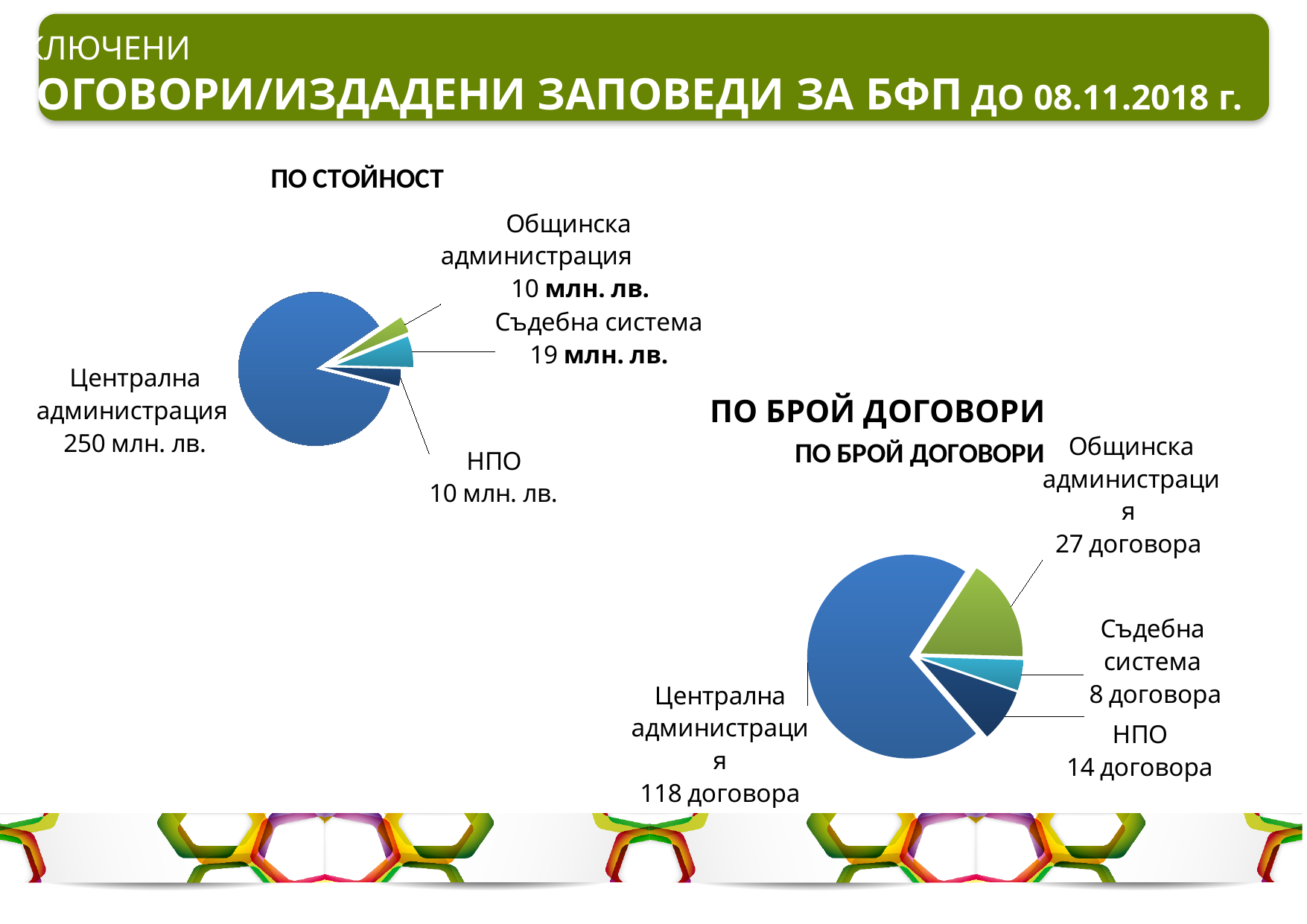
In the "ПО БРОЙ ДОГОВОРИ" chart, which category has the fewest contracts? Съдебна система In the "ПО БРОЙ ДОГОВОРИ" chart, which has more contracts, Общинска администрация or НПО? Общинска администрация In the "ПО СТОЙНОСТ" chart, what is the difference between Съдебна система and НПО? 9 млн. лв. In the "ПО БРОЙ ДОГОВОРИ" chart, how many contracts does НПО have? 14 договора What kind of chart is the "ПО СТОЙНОСТ" chart? Pie chart In the "ПО СТОЙНОСТ" chart, what is the value for Централна администрация? 250 млн. лв. In the "ПО БРОЙ ДОГОВОРИ" chart, how many contracts does Общинска администрация have? 27 договора In the "ПО СТОЙНОСТ" chart, what is the value for Съдебна система? 19 млн. лв. In the "ПО БРОЙ ДОГОВОРИ" chart, what is the difference in contracts between Централна администрация and Общинска администрация? 91 договора In the "ПО БРОЙ ДОГОВОРИ" chart, what is the total number of contracts across all categories? 167 договора In the "ПО СТОЙНОСТ" chart, which category has the largest value? Централна администрация In the "ПО СТОЙНОСТ" chart, how many categories are shown? 4